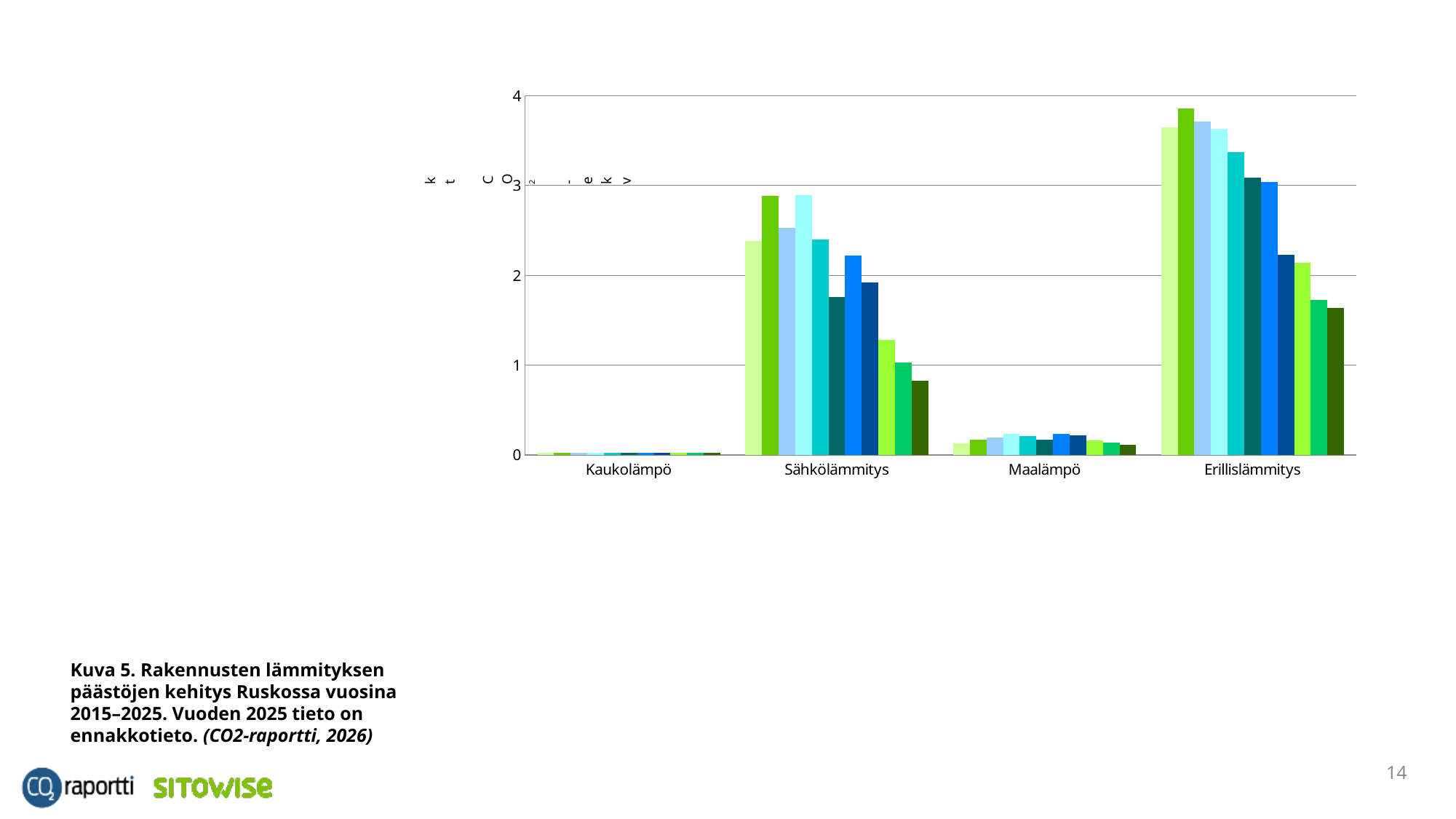
Is the rightmost bar for Sähkölämmitys greater or less than 1? less What unit is shown on the y axis of the chart? kt CO2-ekv How many categories are shown on the x axis of the chart? 4 Is the tallest bar for Erillislämmitys greater or less than 3? greater What kind of chart is shown on the slide? bar chart Which category has higher bars, Sähkölämmitys or Maalämpö? Sähkölämmitys Are all the bars for Maalämpö greater or less than 1? less Within the Erillislämmitys group, do the bars generally rise or fall from left to right? fall Which category has the tallest bar in the chart? Erillislämmitys Which category has the lowest bars in the chart? Kaukolämpö How many bars are there in each category group of the chart? 11